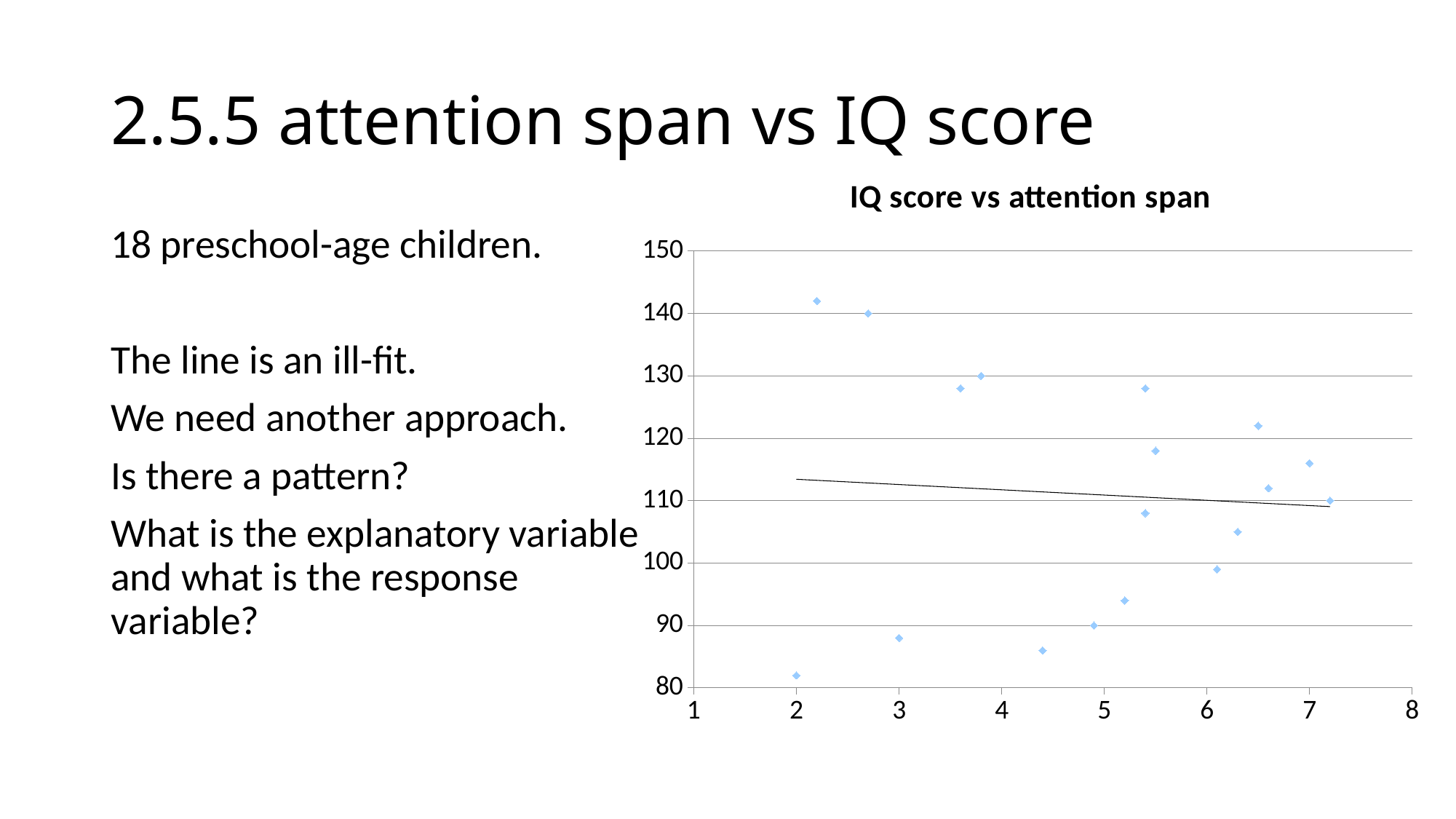
How many data points are plotted in the chart? 18 What is the maximum value shown on the vertical axis of the chart? 150 What kind of chart is shown on the slide? Scatter plot Is the lowest plotted point in the chart greater or less than 90? less Is the highest plotted point in the chart greater or less than 140? greater Is the value of the point at about x = 4.4 greater or less than 90? less What is the title of the chart? IQ score vs attention span Does the fitted line in the chart rise or fall as the x-axis value increases? Fall